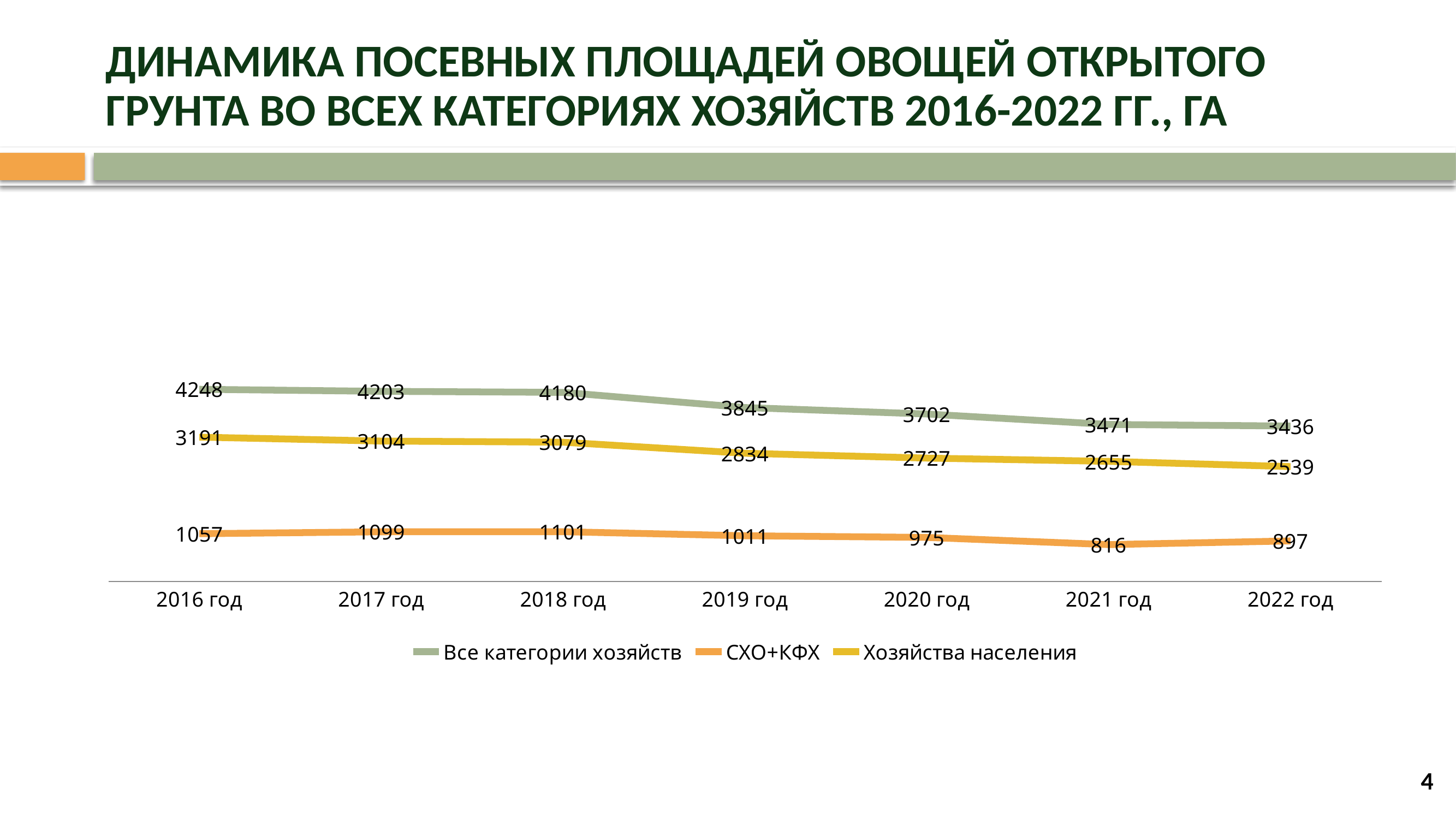
What kind of chart is shown on the slide? Line chart Which colour is used for the "СХО+КФХ" series? Orange What is the value for "СХО+КФХ" in 2021 год? 816 How many series does the legend list? 3 What is the value for "Хозяйства населения" in 2019 год? 2834 In which year is the value for "Все категории хозяйств" lowest? 2022 год Does the "Хозяйства населения" series rise or fall from 2016 год to 2022 год? Fall In which year is the value for "СХО+КФХ" highest? 2018 год What is the value for "Все категории хозяйств" in 2016 год? 4248 What is the difference between the "Все категории хозяйств" values in 2016 год and 2022 год? 812 Which is larger: the "СХО+КФХ" value in 2017 год or in 2022 год? 2017 год How many years are shown on the x axis? 7